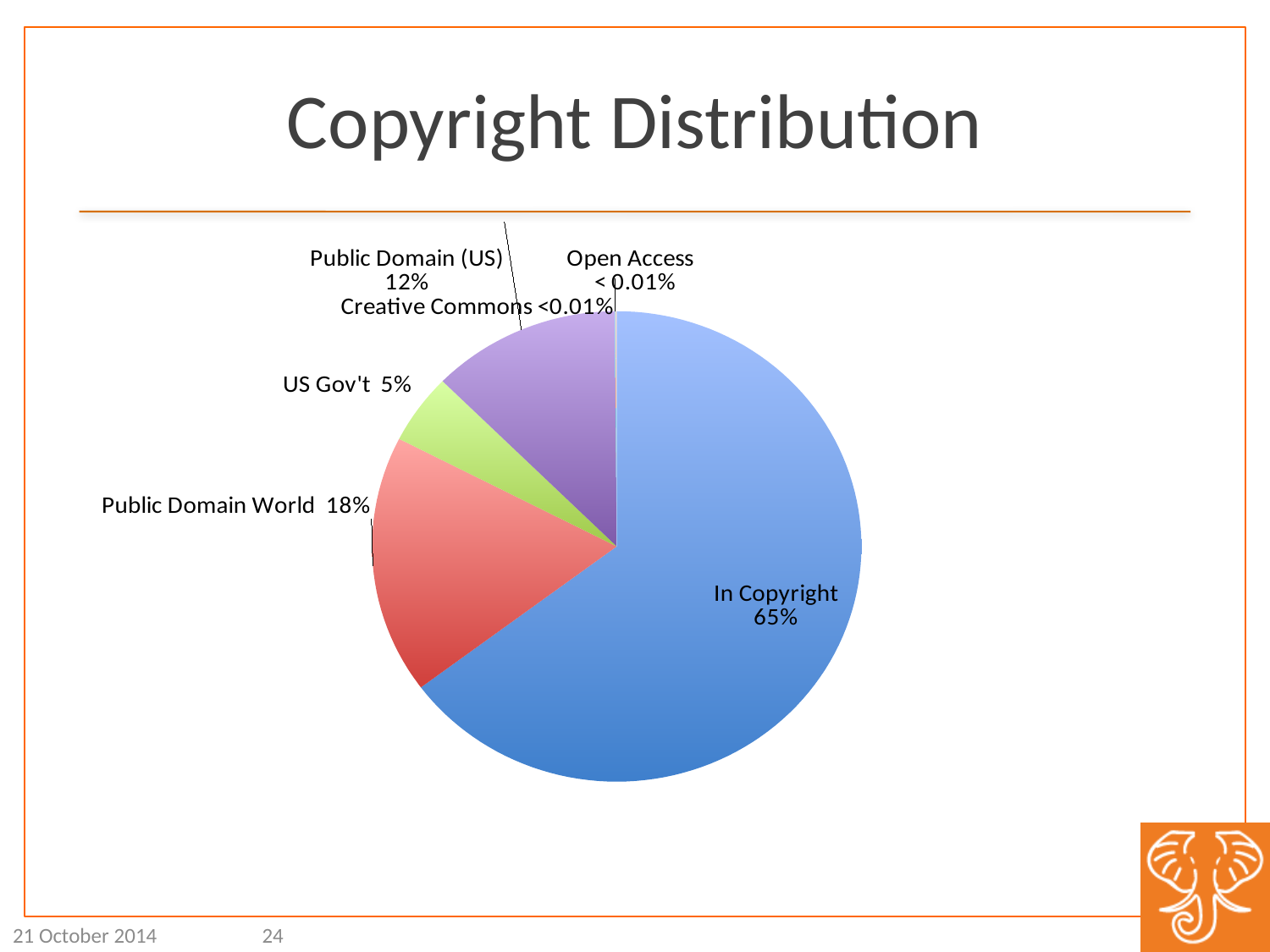
What share of the pie is Public Domain World? 18% What is the difference in percentage points between In Copyright and Public Domain World? 47 Which category has the largest slice of the pie? In Copyright What share of the pie is Open Access? < 0.01% What is the title of the chart? Copyright Distribution What kind of chart is shown on the slide? pie chart What share of the pie is Public Domain (US)? 12% How many categories are shown in the pie chart? 6 Which is larger, Public Domain World or Public Domain (US)? Public Domain World